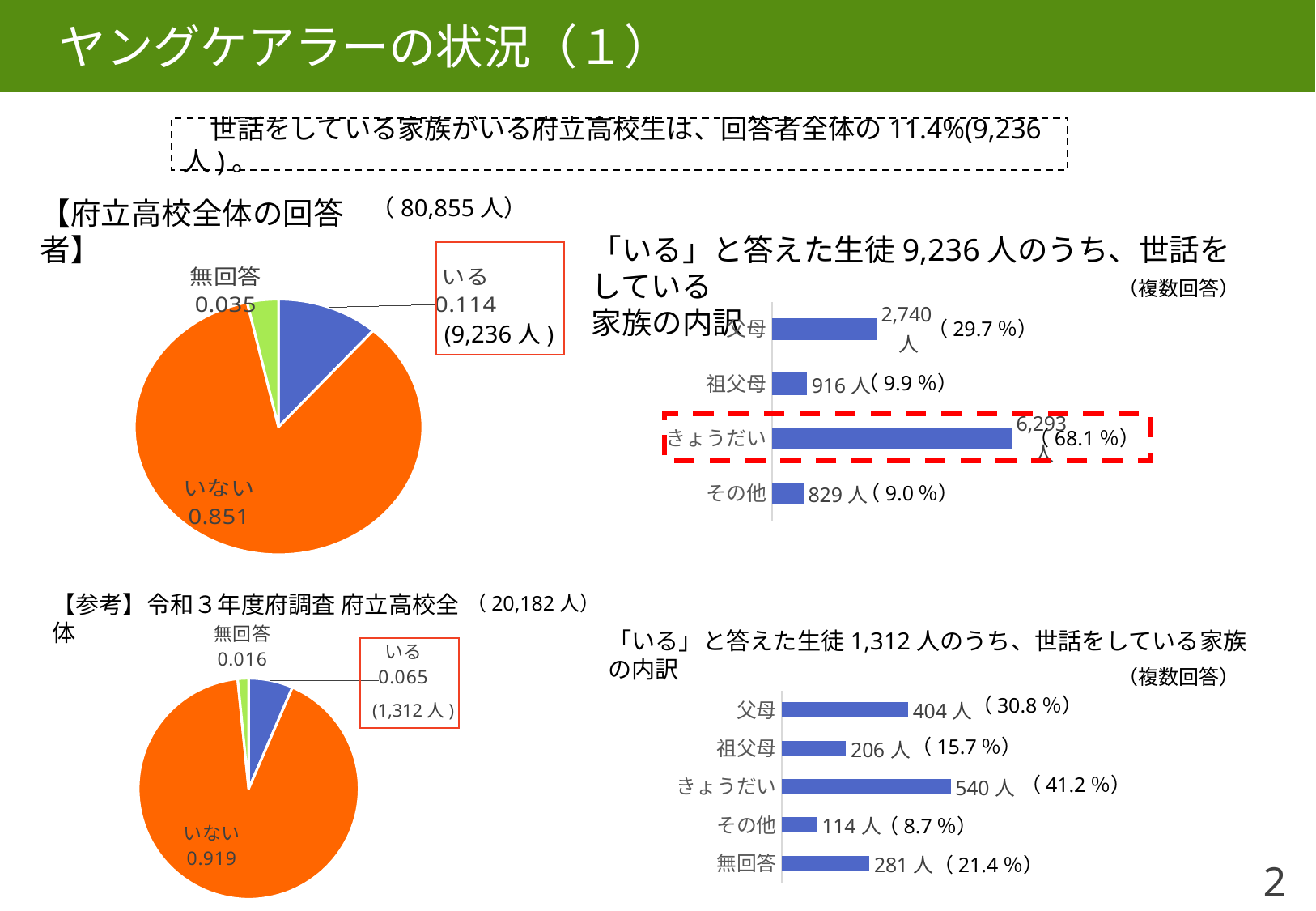
In the top-right bar chart (世話をしている家族の内訳, 9,236人), what percentage is shown for 祖父母? 9.9% In the bottom-left pie chart (令和3年度府調査), what is the value for いる? 0.065 How many slices does the top-left pie chart (府立高校全体の回答者) have? 3 In the top-right bar chart (世話をしている家族の内訳, 9,236人), what is the difference in people between きょうだい and 父母? 3,553人 What type of chart is the bottom-right chart (世話をしている家族の内訳, 1,312人)? Bar chart In the top-right bar chart (世話をしている家族の内訳, 9,236人), how many people answered きょうだい? 6,293人 In the top-left pie chart (府立高校全体の回答者), which slice is the largest? いない In the top-left pie chart (府立高校全体の回答者), what is the value for 無回答? 0.035 In the top-left pie chart (府立高校全体の回答者), what is the value for いない? 0.851 In the bottom-right bar chart (世話をしている家族の内訳, 1,312人), how many categories are shown? 5 In the bottom-right bar chart (世話をしている家族の内訳, 1,312人), which is larger, 祖父母 or 無回答? 無回答 In the top-right bar chart (世話をしている家族の内訳, 9,236人), which category has the lowest number of people? その他